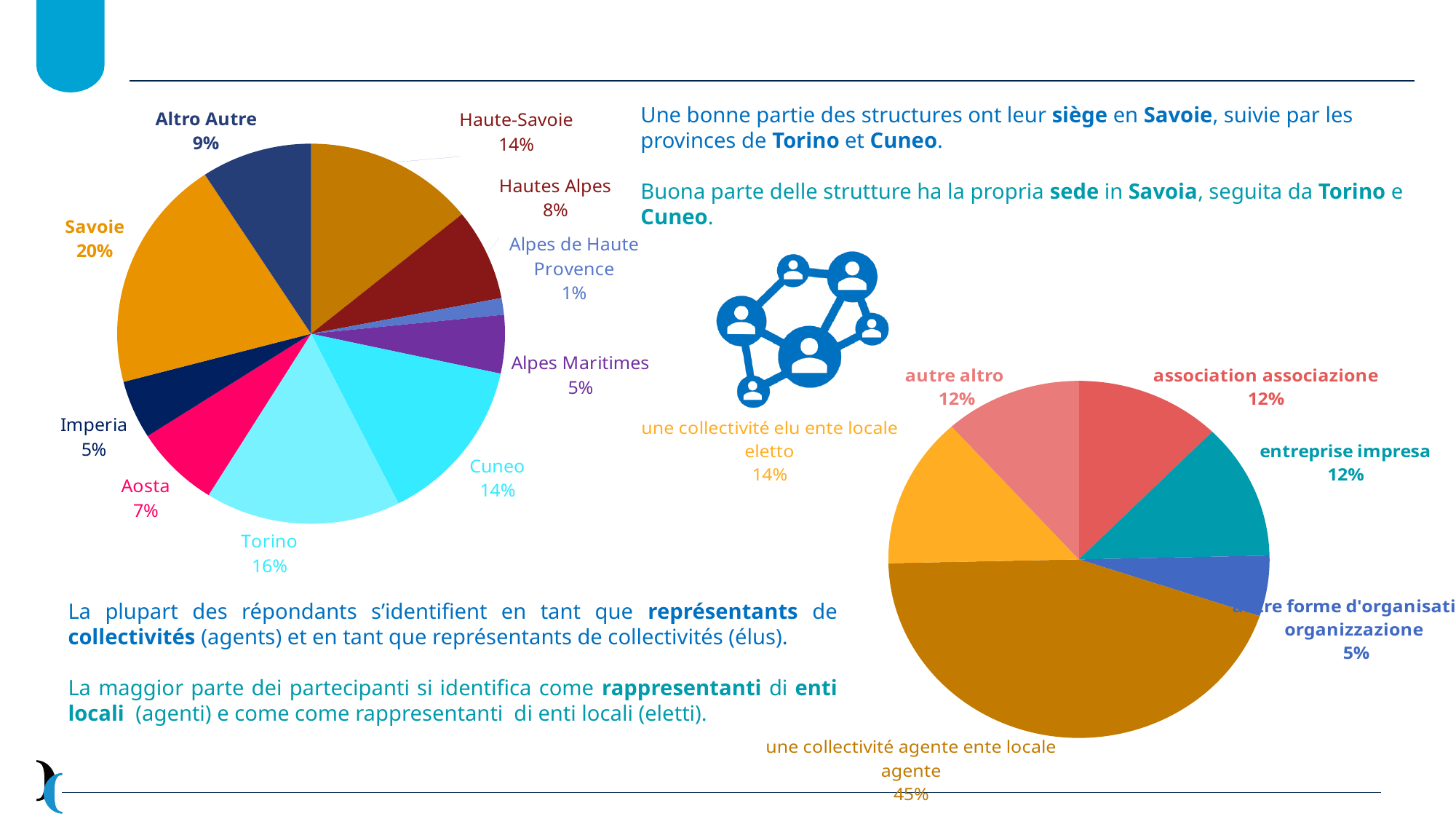
In the right pie chart, which category has the largest share? une collectivité agente ente locale agente In the left pie chart, which category has the smallest share? Alpes de Haute Provence In the right pie chart, what share does 'une collectivité agente ente locale agente' have? 45% How many slices does the right pie chart have? 6 What type of chart is the right chart on the slide? Pie chart In the right pie chart, what share does 'une collectivité elu ente locale eletto' have? 14% How many slices does the left pie chart have? 10 In the left pie chart, what is the difference in percentage points between Savoie and Cuneo? 6 In the left pie chart, which category has the largest share? Savoie In the left pie chart, what share does Savoie have? 20% In the left pie chart, which is larger, Hautes Alpes or Aosta? Hautes Alpes In the left pie chart, what share does Torino have? 16%